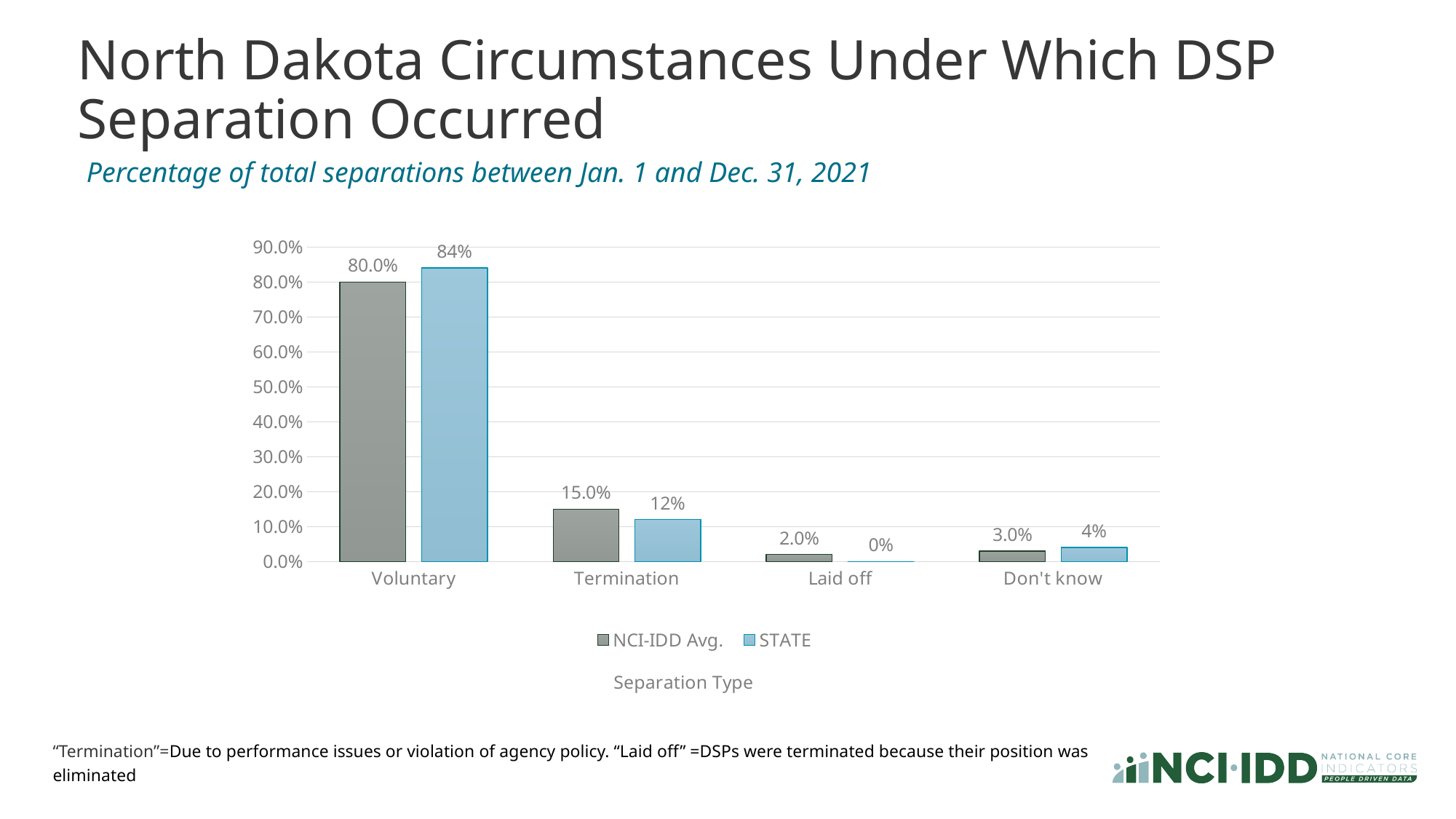
What is the STATE value for Voluntary? 84% What is the NCI-IDD Avg. value for Laid off? 2.0% How many series does the legend list? 2 What is the NCI-IDD Avg. value for Voluntary? 80.0% Which separation type has the highest STATE value? Voluntary For Voluntary, which is larger: the NCI-IDD Avg. value or the STATE value? STATE What kind of chart is shown on the slide? Bar chart What is the difference between the NCI-IDD Avg. and STATE values for Termination? 3 percentage points What is the STATE value for Termination? 12% Which separation type has the lowest STATE value? Laid off What is the STATE value for Don't know? 4% How many separation types are shown on the x axis? 4